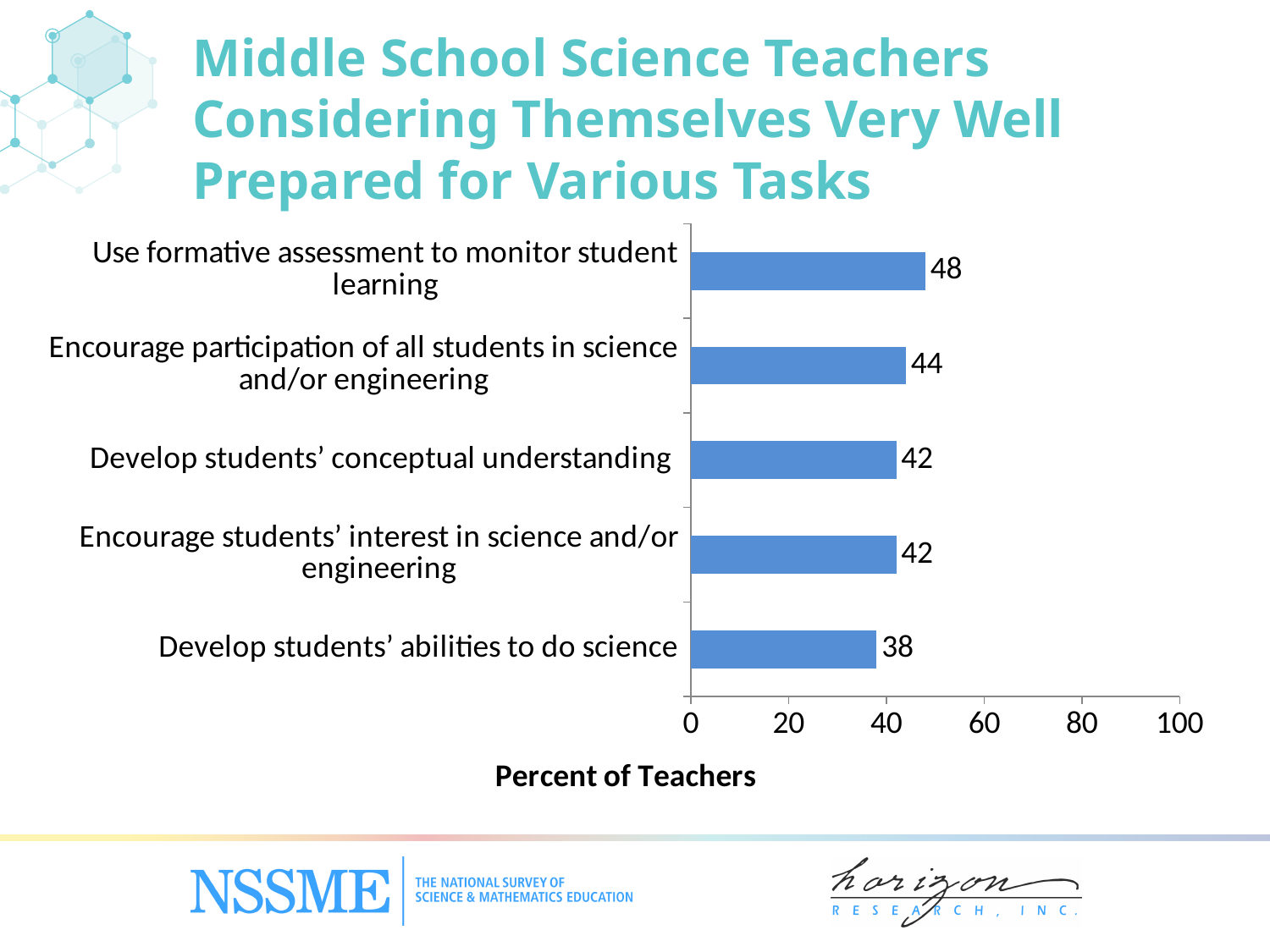
How many tasks are shown in the chart? 5 Is the value for 'Use formative assessment to monitor student learning' greater or less than 40? greater What percent of teachers consider themselves very well prepared to use formative assessment to monitor student learning? 48 What kind of chart is shown on the slide? bar chart What is the difference between the values for 'Use formative assessment to monitor student learning' and 'Develop students' abilities to do science'? 10 Which task has the lowest percent of teachers considering themselves very well prepared? Develop students' abilities to do science Which is larger: the value for 'Encourage participation of all students in science and/or engineering' or the value for 'Develop students' conceptual understanding'? Encourage participation of all students in science and/or engineering What is the value for 'Develop students' abilities to do science'? 38 Which task has the highest percent of teachers considering themselves very well prepared? Use formative assessment to monitor student learning What is the maximum value shown on the horizontal axis? 100 What is the value for 'Encourage participation of all students in science and/or engineering'? 44 What is the label of the horizontal axis? Percent of Teachers